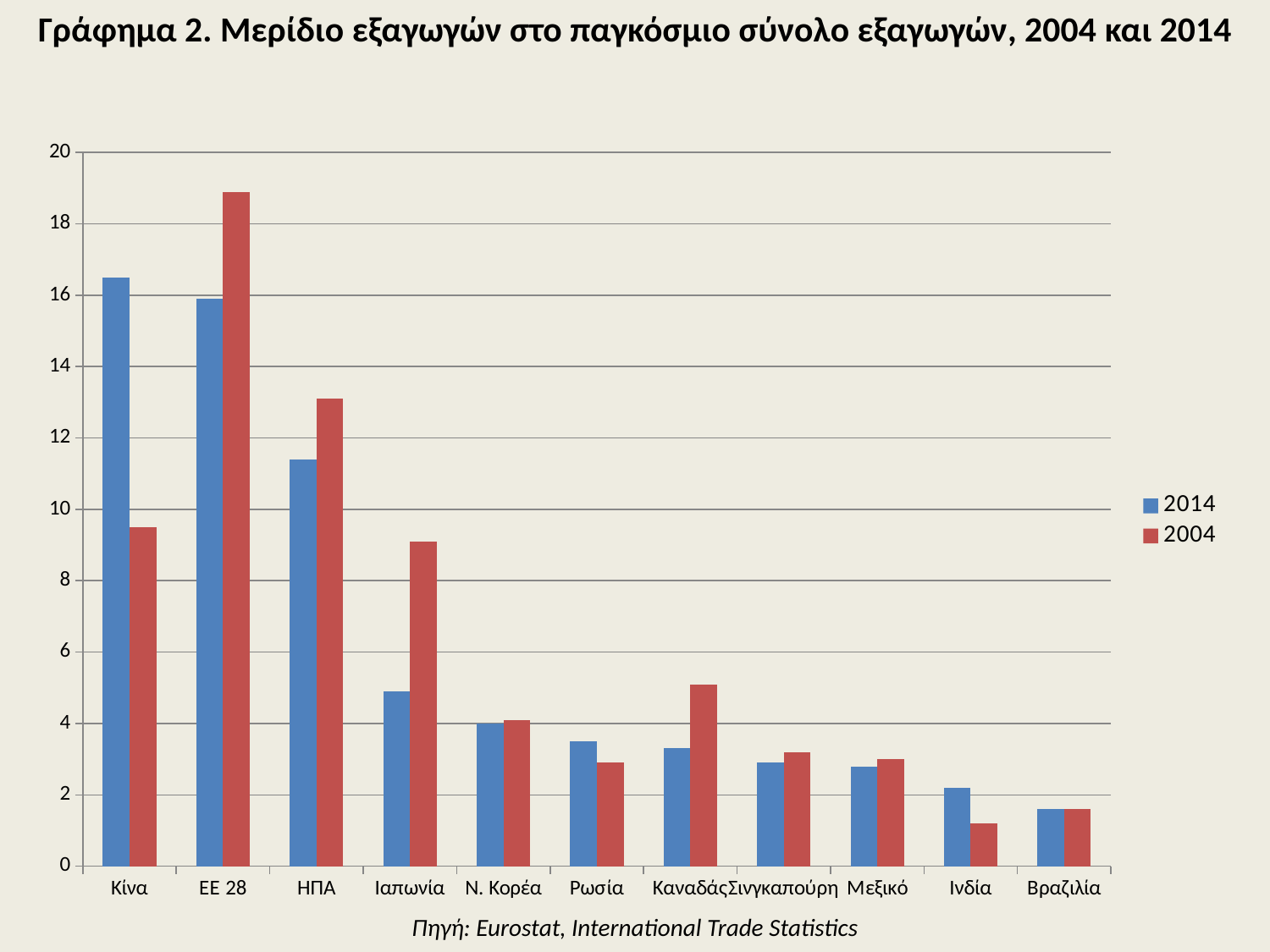
Which series is shown in blue according to the legend? 2014 Is the 2004 value for Ινδία greater or less than 2? less Is the 2014 value for Κίνα greater or less than 16? greater For Ιαπωνία, which series has the larger value, 2014 or 2004? 2004 Which category has the lowest value for the 2014 series? Βραζιλία What kind of chart is shown on the slide? bar chart Is the 2004 value for Ιαπωνία greater or less than 8? greater Which category has the lowest value for the 2004 series? Ινδία Which category has the highest value for the 2014 series? Κίνα How many countries/regions are shown on the x axis? 11 Which category has the highest value for the 2004 series? ΕΕ 28 How many series does the legend list? 2